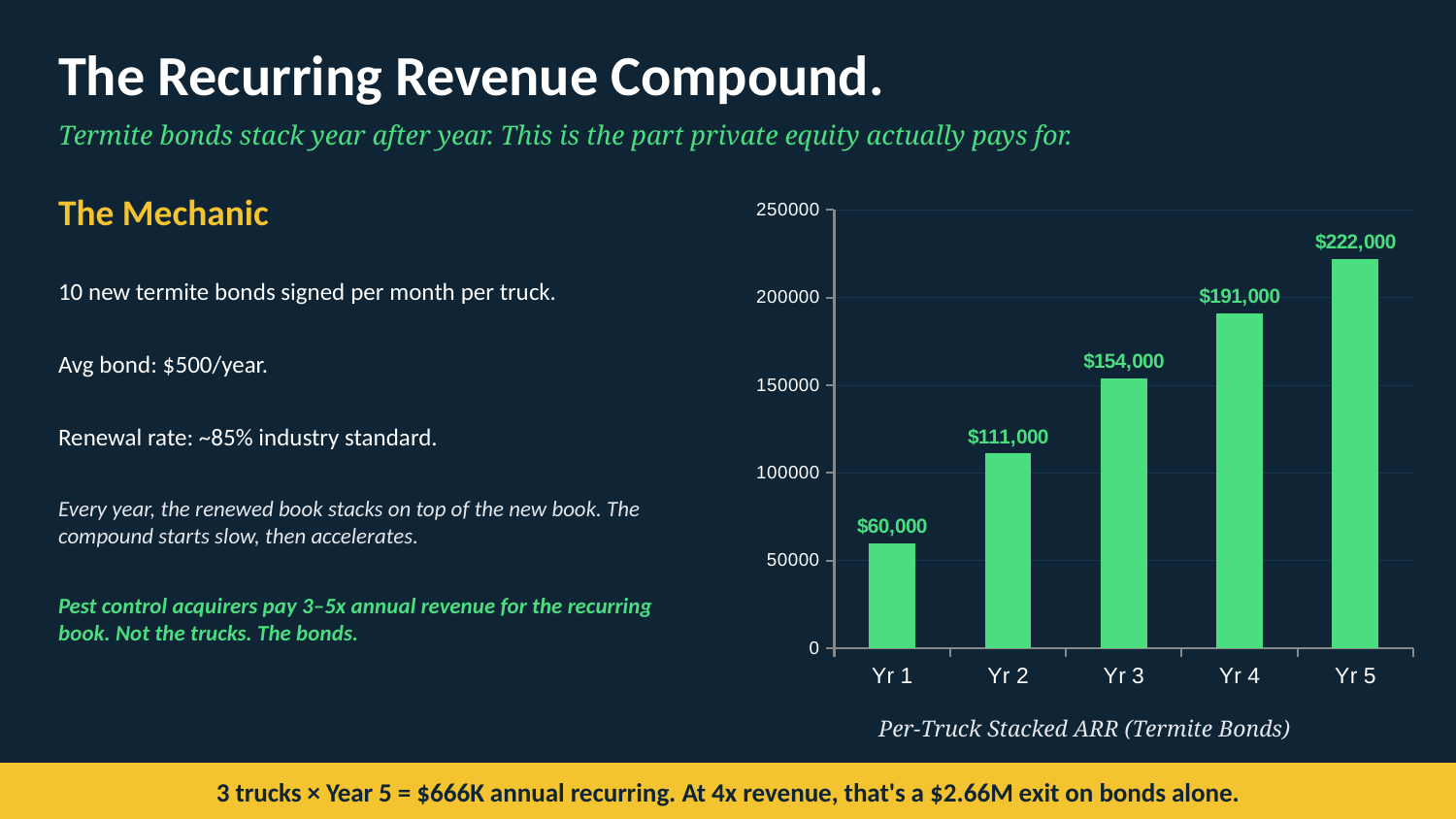
What is the value for Yr 1? $60,000 What is the value for Yr 5? $222,000 Which year has the lowest value? Yr 1 What kind of chart is shown on the slide? Bar chart What is the difference between the values for Yr 5 and Yr 4? $31,000 What is the difference between the values for Yr 2 and Yr 1? $51,000 Which year has the highest value? Yr 5 Is the value for Yr 4 greater or less than 150000? greater Which is larger, the value for Yr 3 or the value for Yr 2? Yr 3 How many years are shown on the x axis? 5 What is the value for Yr 3? $154,000 Do the values rise or fall from Yr 1 to Yr 5? Rise